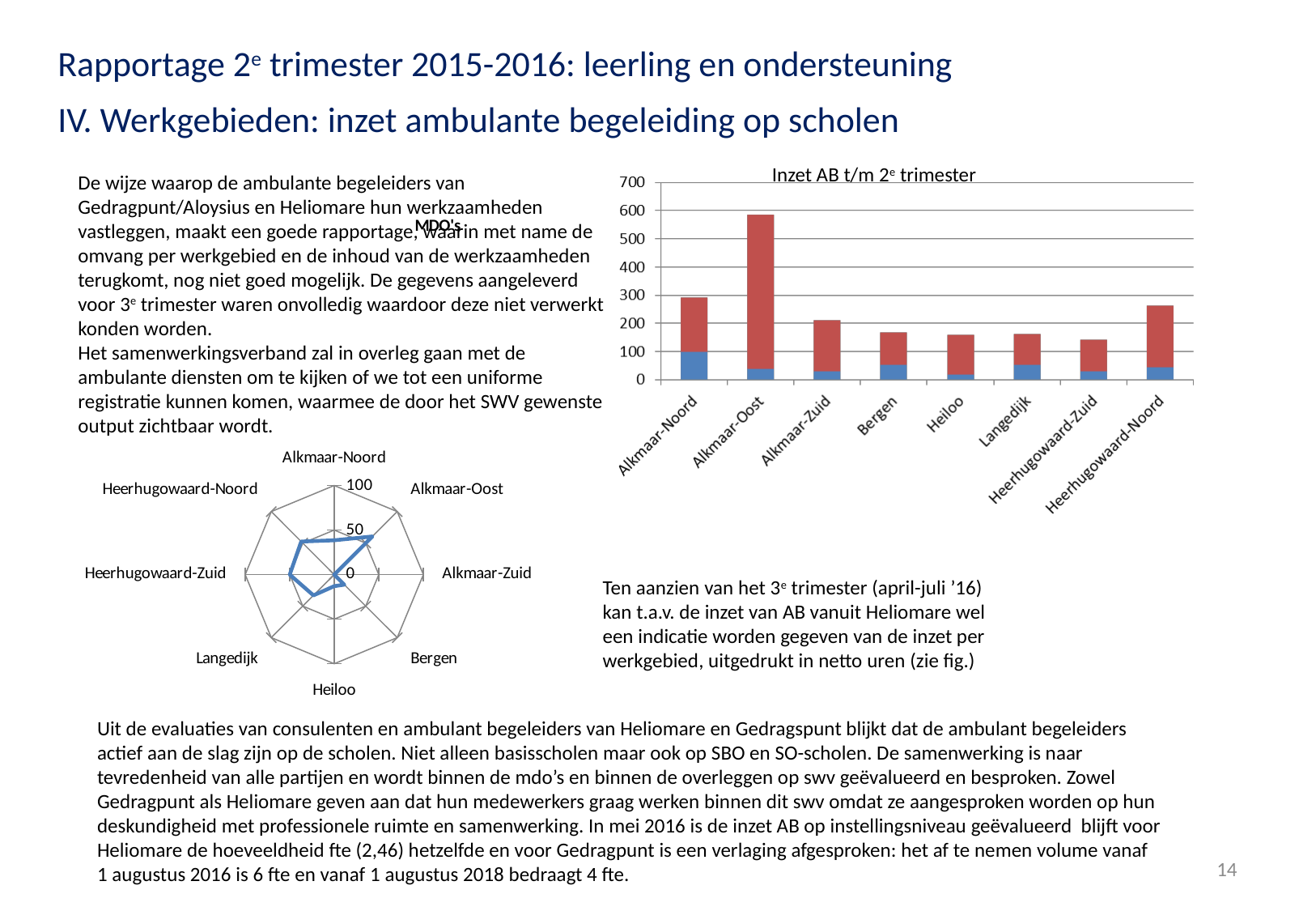
In the radar chart titled 'MDO's', is the value for Alkmaar-Zuid greater or less than 50? less How many categories are shown around the radar chart titled 'MDO's'? 8 What kind of chart is the chart titled 'Inzet AB t/m 2e trimester'? Stacked bar chart In the chart titled 'Inzet AB t/m 2e trimester', is the total value for Bergen greater or less than 200? less How many werkgebieden are shown on the x axis of the chart titled 'Inzet AB t/m 2e trimester'? 8 What kind of chart is the chart titled 'MDO's' on the left side of the slide? Radar chart In the chart titled 'Inzet AB t/m 2e trimester', which has the larger total bar: Alkmaar-Zuid or Bergen? Alkmaar-Zuid In the chart titled 'Inzet AB t/m 2e trimester', which werkgebied has the highest total bar? Alkmaar-Oost In the chart titled 'Inzet AB t/m 2e trimester', is the total value for Alkmaar-Oost greater or less than 500? greater What is the title of the chart on the right side of the slide? Inzet AB t/m 2e trimester In the chart titled 'Inzet AB t/m 2e trimester', which werkgebied has the lowest total bar? Heerhugowaard-Zuid